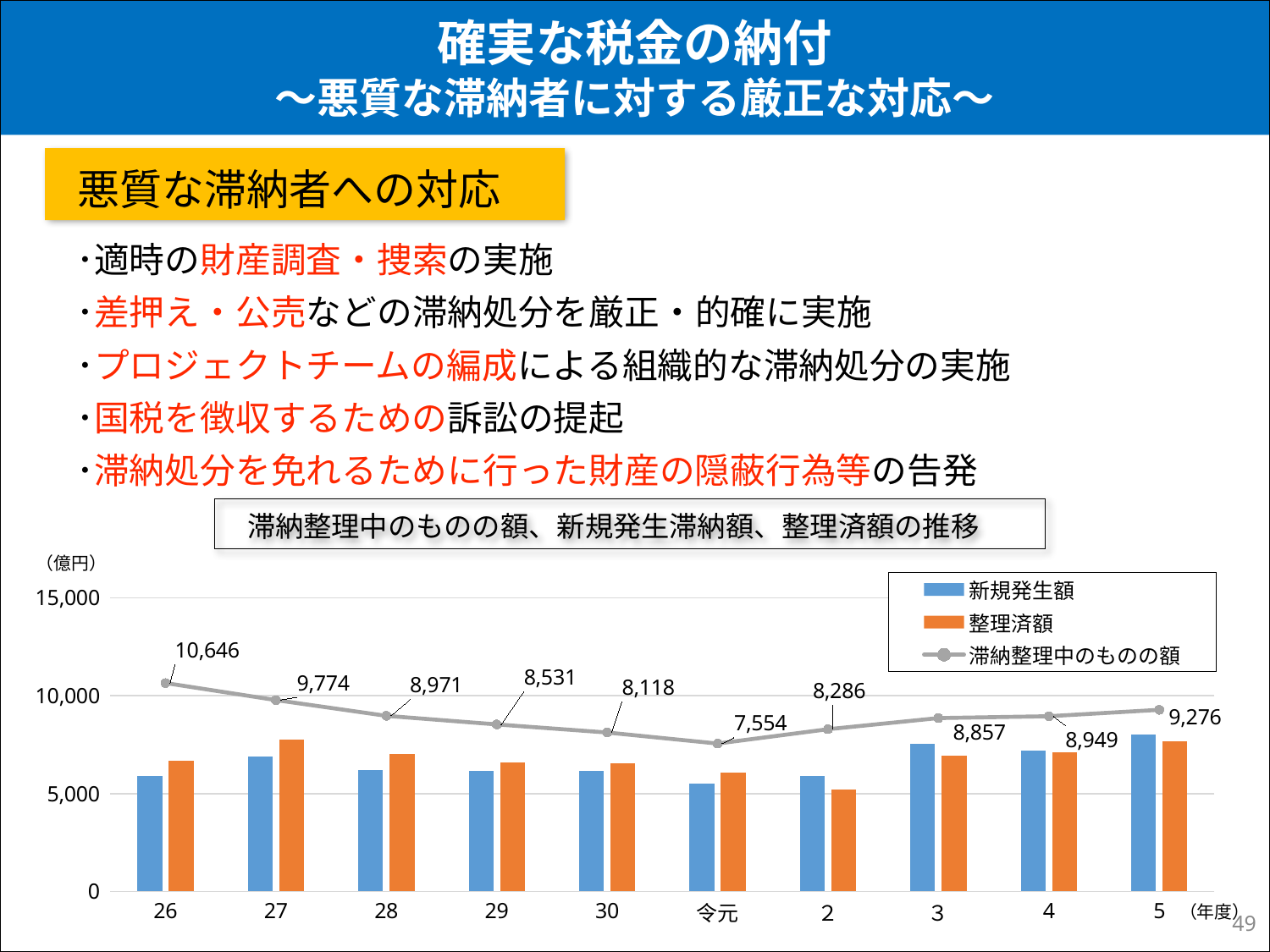
How many series does the legend list? 3 What is the difference between 滞納整理中のものの額 for 26 and for 27? 872 What is the value of 滞納整理中のものの額 for 5? 9,276 Does 滞納整理中のものの額 rise or fall from 26 to 令元? fall Is the value of 新規発生額 for 5 greater or less than 5,000? greater What is the value of 滞納整理中のものの額 for 令元? 7,554 In 27, which bar is taller, 新規発生額 or 整理済額? 整理済額 How many years are shown on the x axis? 10 Which is larger, 滞納整理中のものの額 for 3 or for 4? 4 What is the value of 滞納整理中のものの額 for 26? 10,646 In which year is 滞納整理中のものの額 the highest? 26 In which year is 滞納整理中のものの額 the lowest? 令元